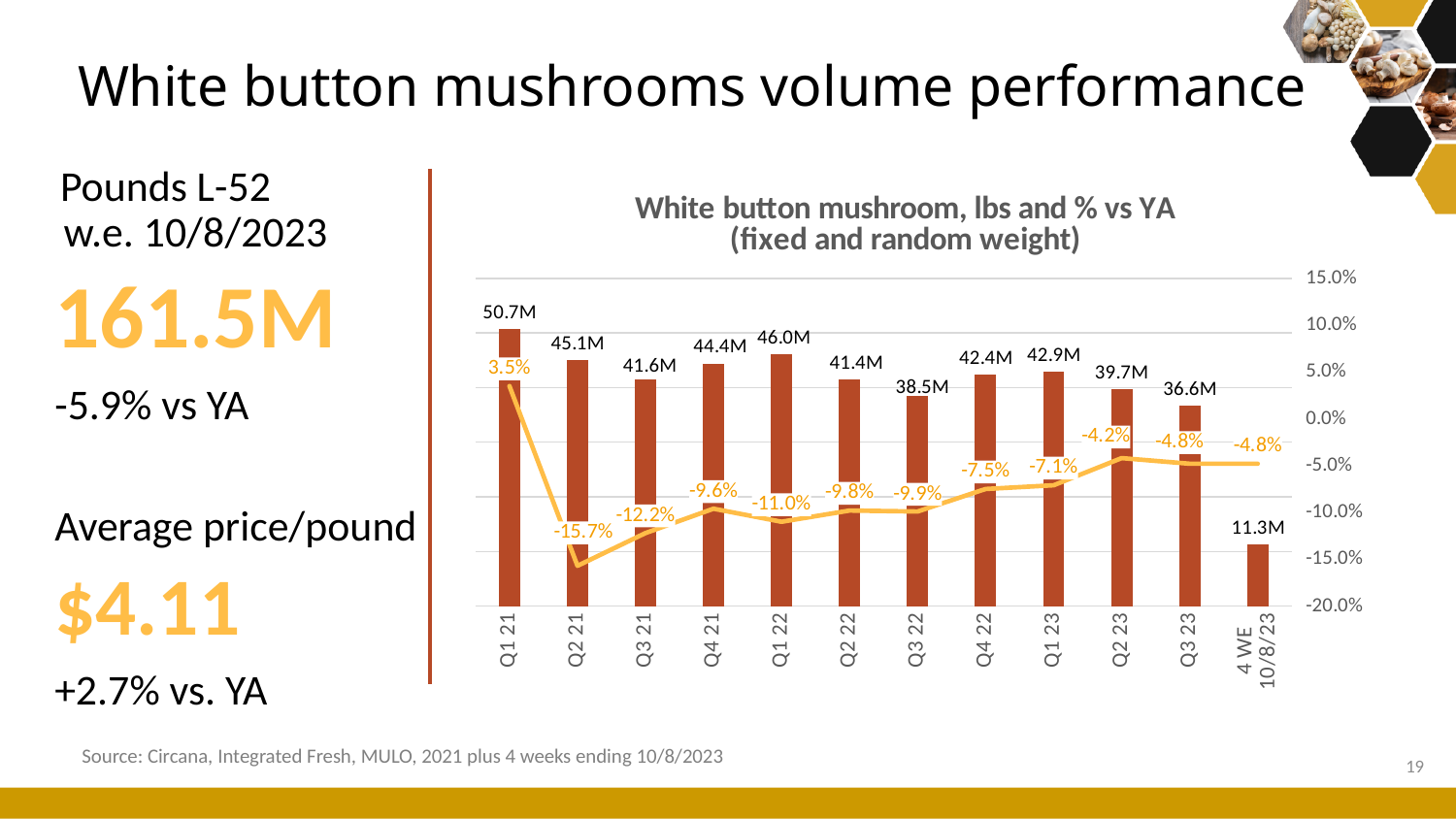
What is the title of the chart? White button mushroom, lbs and % vs YA (fixed and random weight) Which is larger, the volume for Q4 22 or Q1 23? Q1 23 How many periods are shown on the x axis? 12 Does the % vs YA line rise or fall from Q2 21 to Q2 23? Rise What kind of chart is shown? Combination bar and line chart What is the volume in pounds for Q3 23? 36.6M What is the volume in pounds for Q1 21? 50.7M Which period has the lowest % vs YA value? Q2 21 What is the difference in pounds between Q1 22 and Q2 22? 4.6M What is the % vs YA value for Q2 23? -4.2% Which period has the highest volume in pounds? Q1 21 What is the % vs YA value for Q2 21? -15.7%